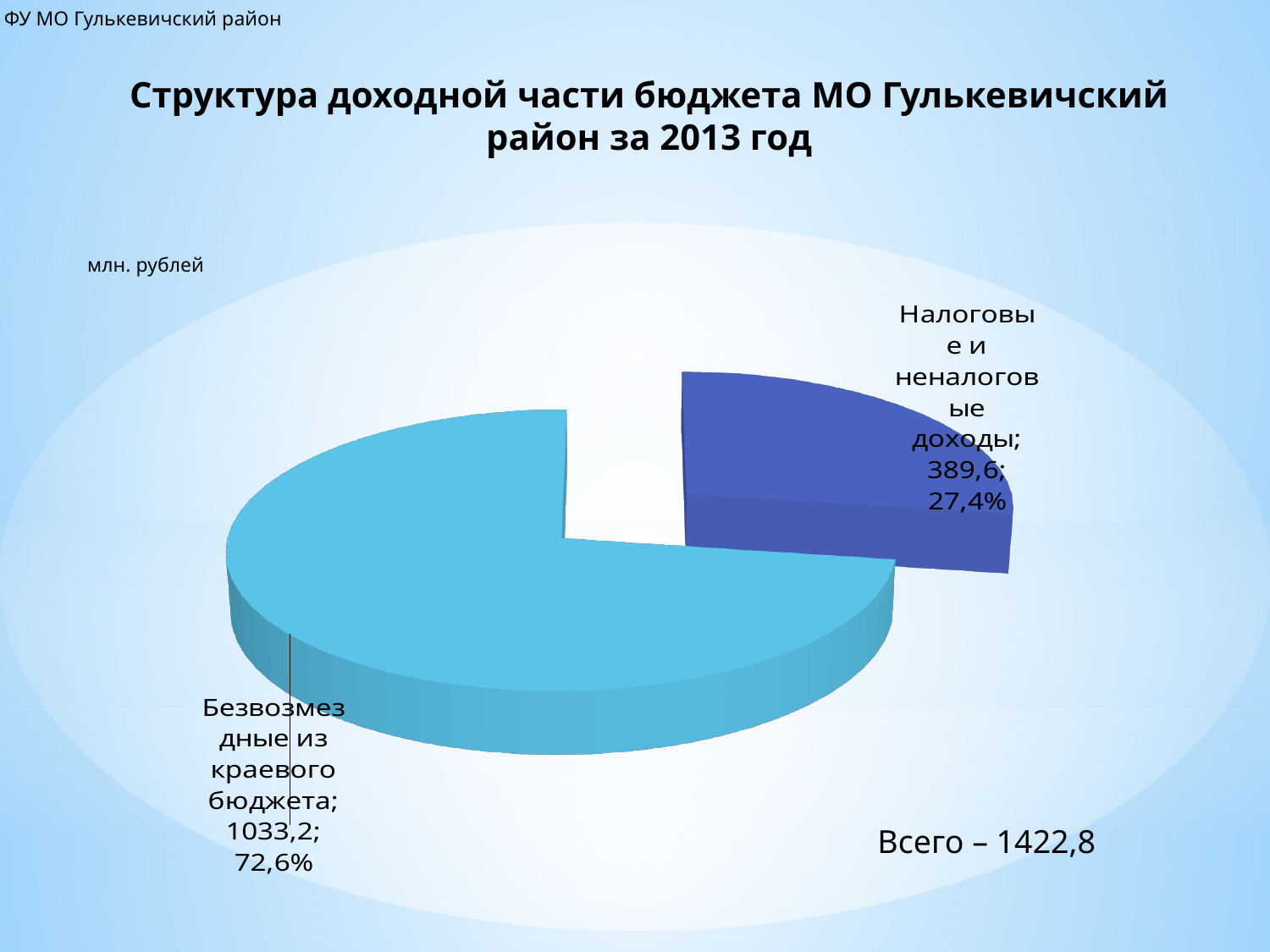
What share of the pie does "Налоговые и неналоговые доходы" represent? 27,4% What is the difference between the values for "Безвозмездные из краевого бюджета" and "Налоговые и неналоговые доходы"? 643,6 What kind of chart is shown on the slide? Pie chart What is the value for "Безвозмездные из краевого бюджета"? 1033,2 What share of the pie does "Безвозмездные из краевого бюджета" represent? 72,6% What is the value for "Налоговые и неналоговые доходы"? 389,6 In what units are the chart values given? млн. рублей Which slice is the smallest? Налоговые и неналоговые доходы Which slice is the largest? Безвозмездные из краевого бюджета What total ("Всего") is stated on the slide? 1422,8 Which is larger: "Налоговые и неналоговые доходы" or "Безвозмездные из краевого бюджета"? Безвозмездные из краевого бюджета How many slices does the pie chart have? 2